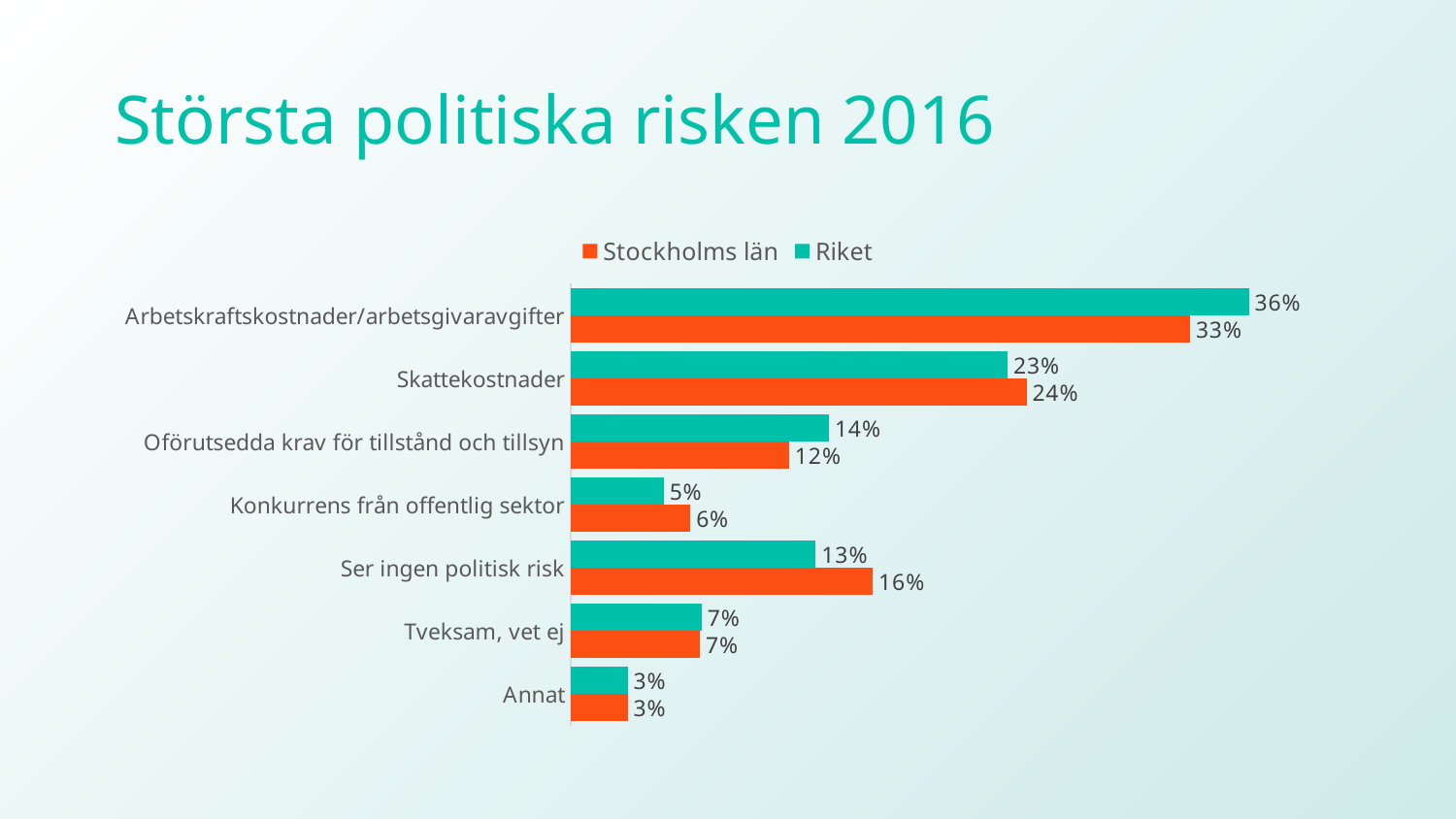
What is the Stockholms län value for Skattekostnader? 24% What is the Riket value for Arbetskraftskostnader/arbetsgivaravgifter? 36% Which colour represents Riket in the chart? Teal (green) Which category has the highest Riket value? Arbetskraftskostnader/arbetsgivaravgifter What is the difference between the Riket and Stockholms län values for Arbetskraftskostnader/arbetsgivaravgifter? 3% What is the title of the slide? Största politiska risken 2016 Which is larger for Ser ingen politisk risk: the Stockholms län value or the Riket value? Stockholms län Which category has the lowest Stockholms län value? Annat What is the Stockholms län value for Ser ingen politisk risk? 16% How many categories are shown on the chart? 7 What kind of chart is shown on the slide? Bar chart How many series does the legend list? 2